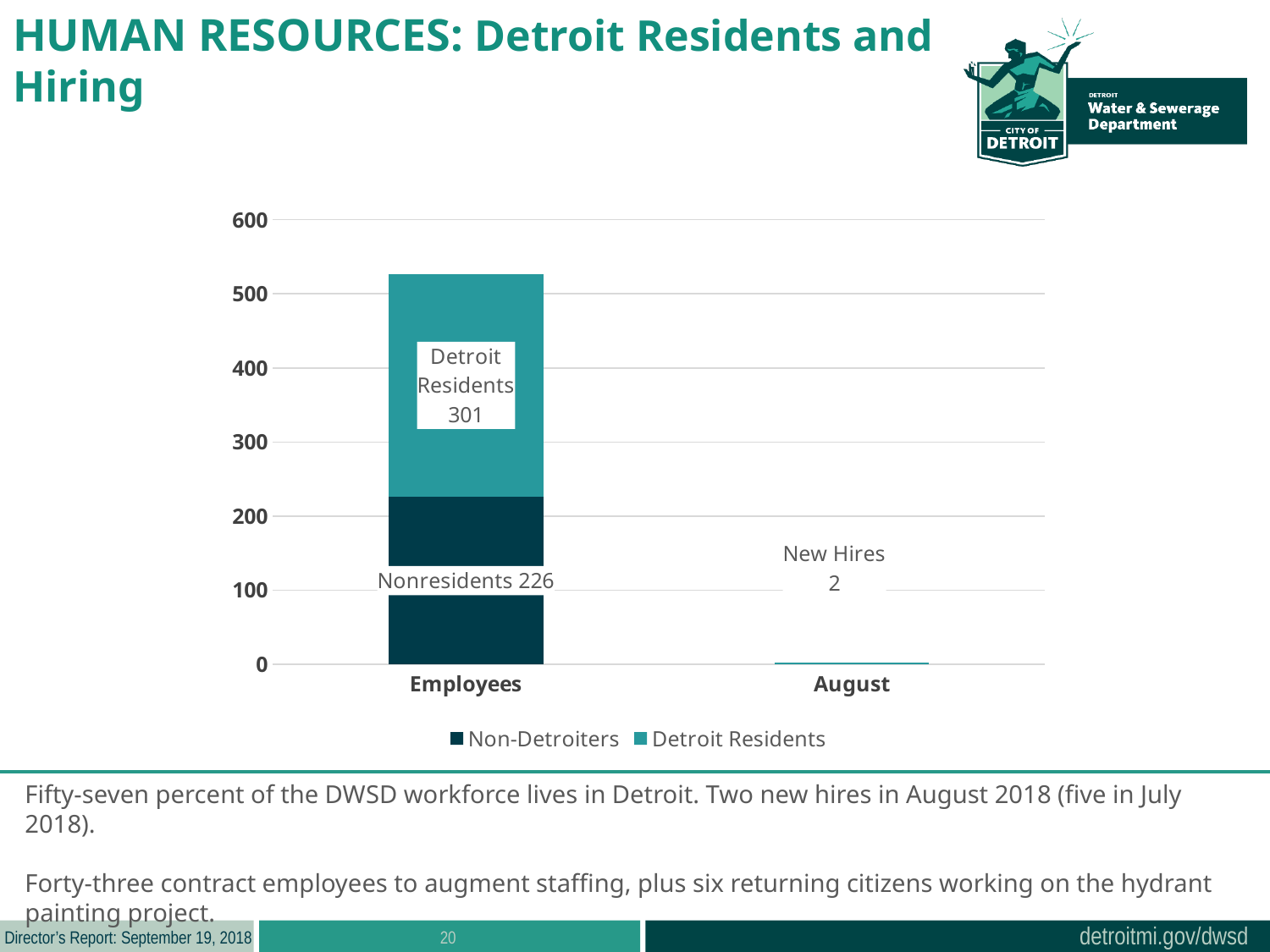
What are the two entries in the chart legend? Non-Detroiters and Detroit Residents What is the total of the stacked Employees bar (Nonresidents plus Detroit Residents)? 527 What is the difference between the number of Detroit Residents and the number of Nonresidents in the Employees bar? 75 How many series does the chart legend list? 2 Which legend series is shown in the darker navy colour? Non-Detroiters How many categories are shown on the x axis of the chart? 2 How many Detroit Residents are shown in the Employees bar? 301 How many Nonresidents are shown in the Employees bar? 226 What kind of chart is shown on the slide? Stacked bar chart Is the total height of the Employees bar greater or less than 500? greater In the Employees bar, which is larger: Detroit Residents or Nonresidents? Detroit Residents What is the value labelled for New Hires in the August category? 2